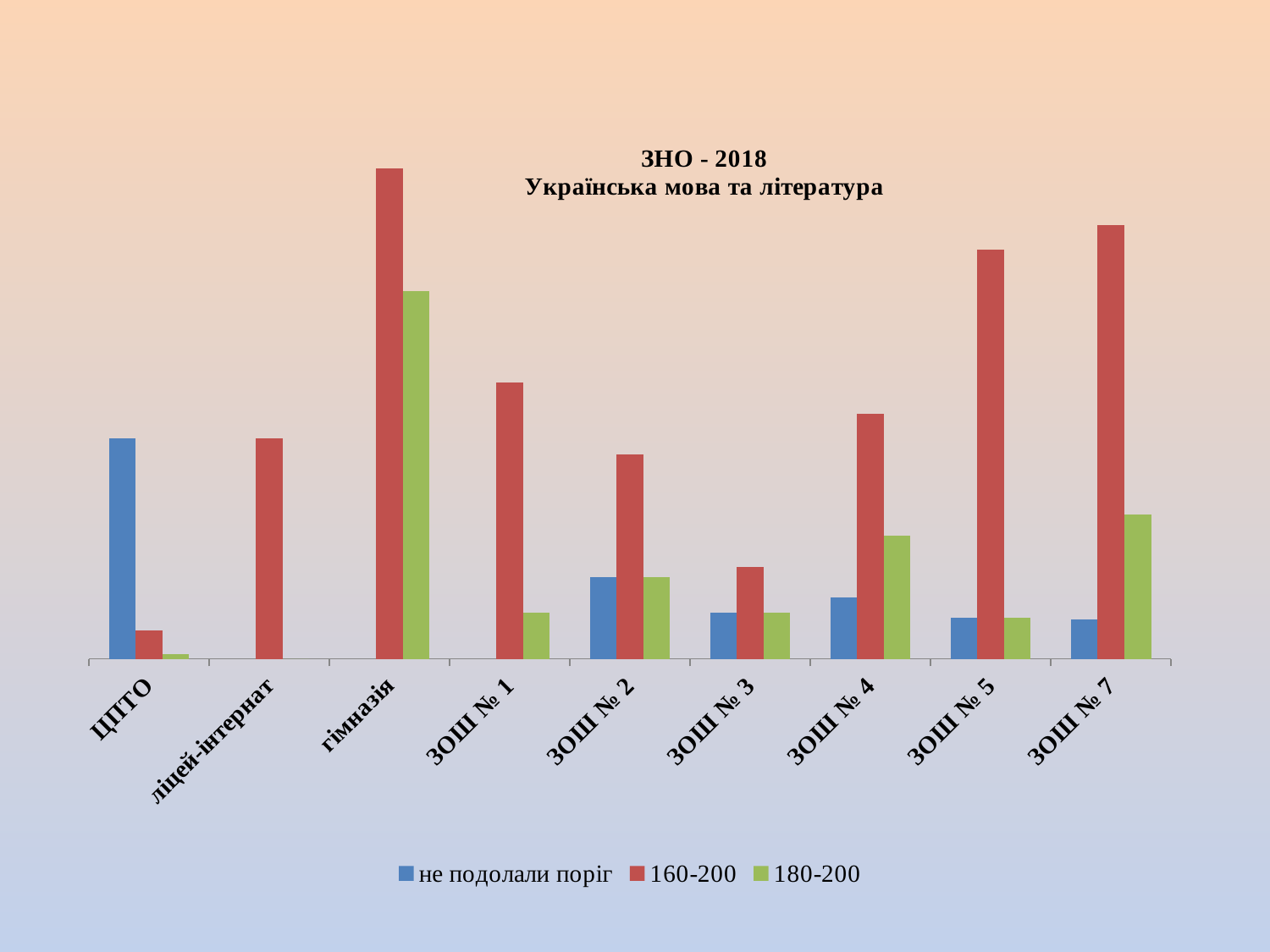
For the 160-200 series, which is larger: ЗОШ № 5 or ЗОШ № 7? ЗОШ № 7 Which category has the highest value for the 180-200 series? гімназія Which category has the lowest value for the 160-200 series? ЦПТО How many schools (categories) are shown on the x axis of the chart? 9 For the 160-200 series, which is larger: ЗОШ № 1 or ЗОШ № 2? ЗОШ № 1 Which colour represents the 180-200 series in the chart? green Which category has the highest value for the 160-200 series? гімназія For the 'не подолали поріг' series, which is larger: ЗОШ № 2 or ЗОШ № 3? ЗОШ № 2 Which category has the highest value for the 'не подолали поріг' series? ЦПТО What is the title of the chart? ЗНО - 2018 Українська мова та література How many series does the legend of the chart list? 3 What kind of chart is shown on the slide? bar chart